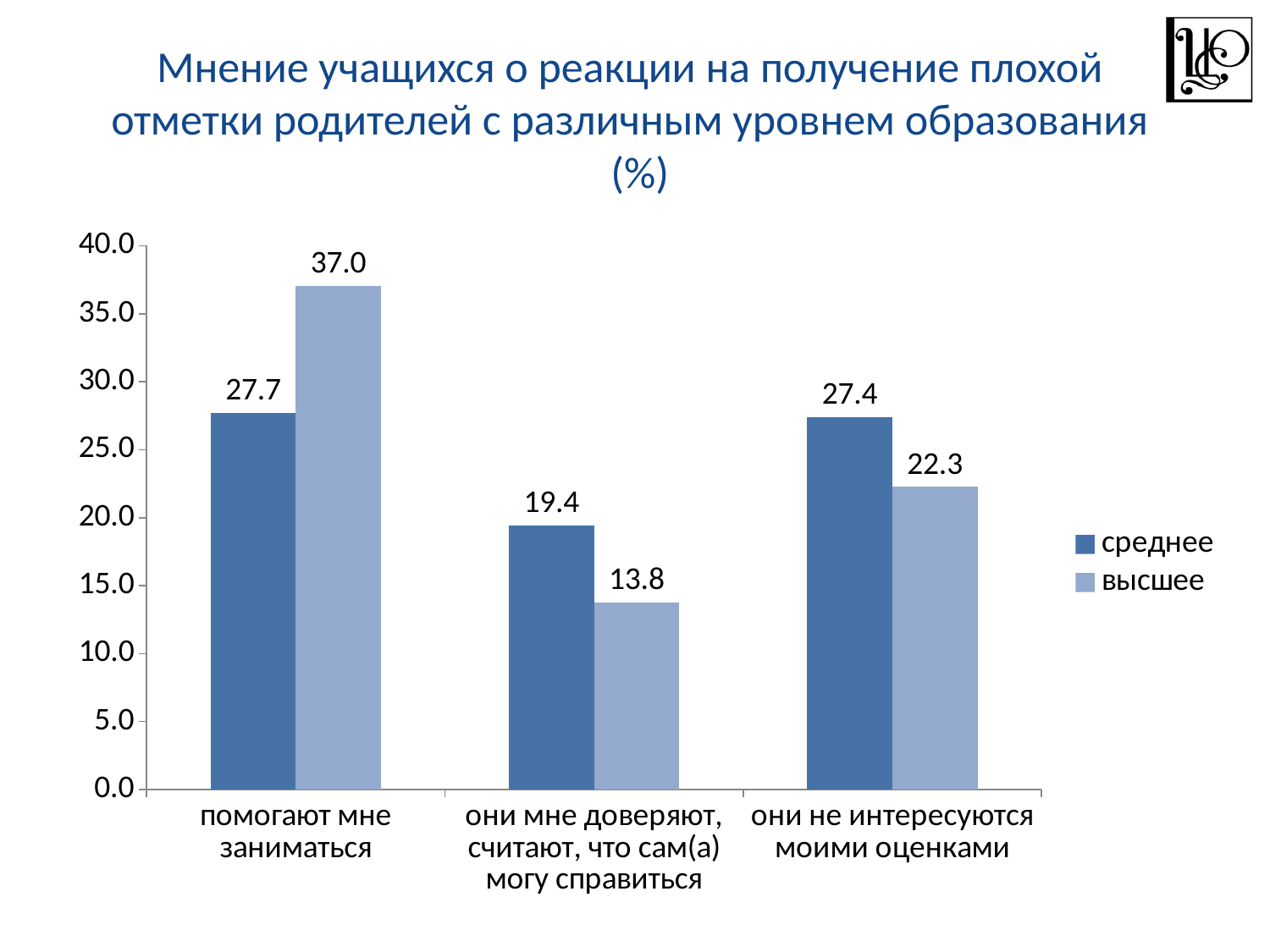
What is the value for "высшее" in the category "они не интересуются моими оценками"? 22.3 What are the two series named in the legend? среднее, высшее What kind of chart is shown on the slide? bar chart Which category has the lowest value for the "среднее" series? они мне доверяют, считают, что сам(а) могу справиться What is the value for "высшее" in the category "они мне доверяют, считают, что сам(а) могу справиться"? 13.8 How many categories are shown on the x axis? 3 Which category has the highest value for the "высшее" series? помогают мне заниматься How many series does the legend list? 2 In the category "они не интересуются моими оценками", which series has the larger value, "среднее" or "высшее"? среднее Is the value for "среднее" in the category "они мне доверяют, считают, что сам(а) могу справиться" greater or less than 20.0? less What is the difference between the "высшее" and "среднее" values in the category "помогают мне заниматься"? 9.3 What is the value for "среднее" in the category "помогают мне заниматься"? 27.7